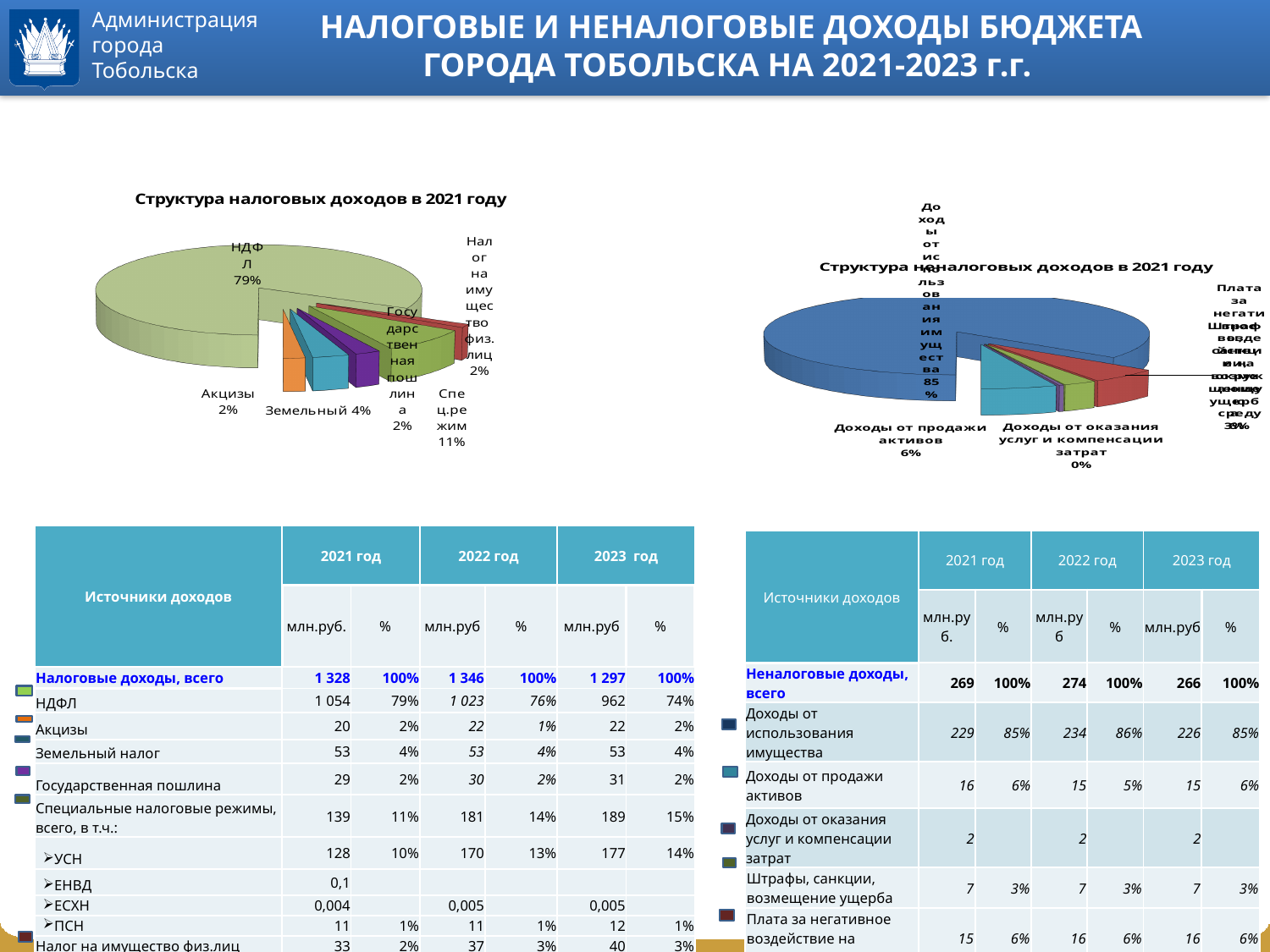
In the chart "Структура налоговых доходов в 2021 году", what share does НДФЛ have? 79% What kind of chart is "Структура неналоговых доходов в 2021 году"? Pie chart How many slices does the chart "Структура налоговых доходов в 2021 году" have? 6 In the chart "Структура неналоговых доходов в 2021 году", what share is shown for Доходы от продажи активов? 6% In the chart "Структура налоговых доходов в 2021 году", what share is shown for Земельный? 4% In the chart "Структура неналоговых доходов в 2021 году", what share is shown for Доходы от оказания услуг и компенсации затрат? 0% In the chart "Структура налоговых доходов в 2021 году", which category has the largest slice? НДФЛ In the chart "Структура налоговых доходов в 2021 году", which is larger: Земельный or Акцизы? Земельный In the chart "Структура налоговых доходов в 2021 году", what share is shown for Спец.режим? 11% In the chart "Структура налоговых доходов в 2021 году", by how many percentage points does НДФЛ exceed Спец.режим? 68 percentage points In the chart "Структура неналоговых доходов в 2021 году", which category has the largest slice? Доходы от использования имущества What kind of chart is "Структура налоговых доходов в 2021 году"? Pie chart